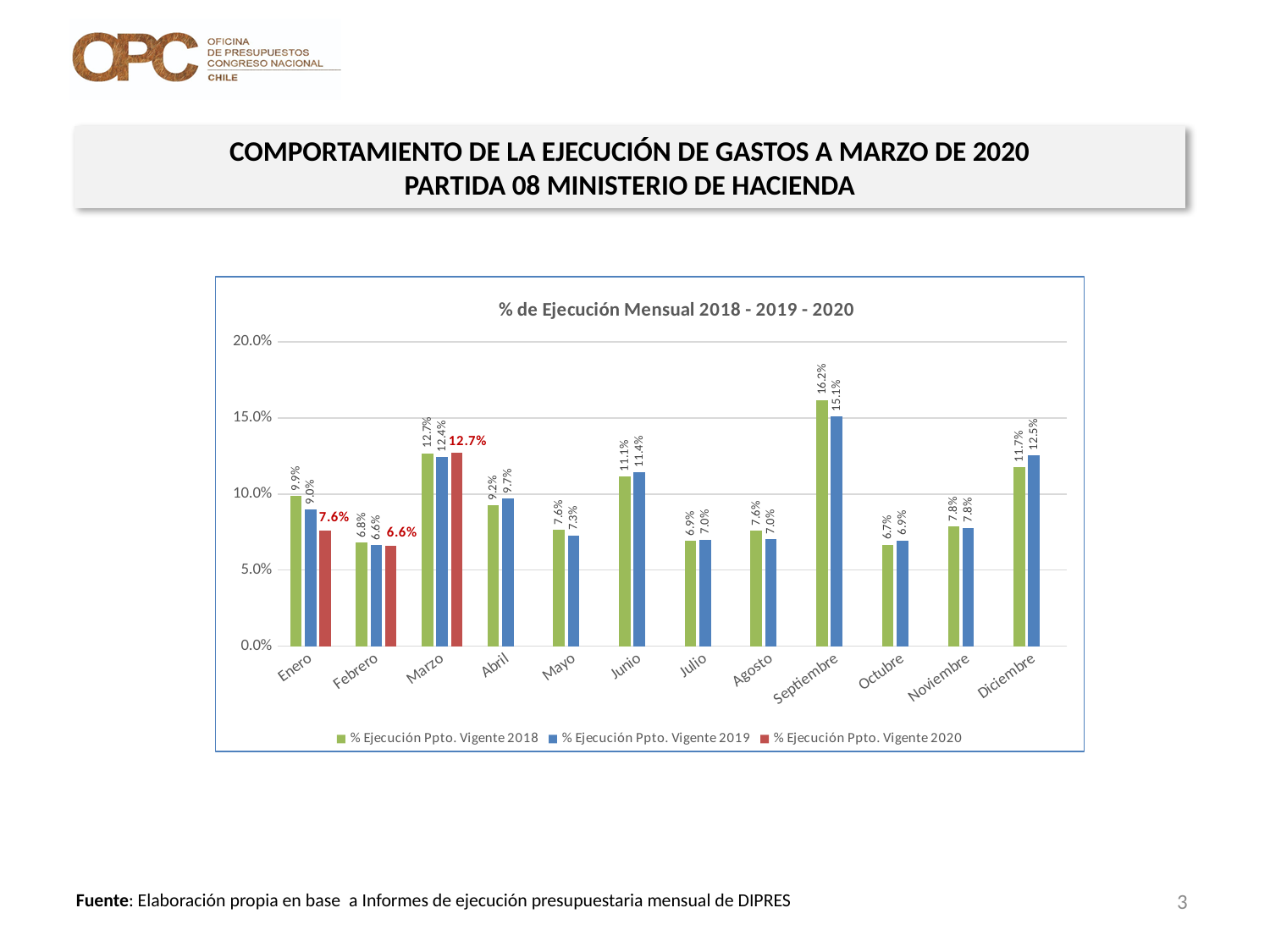
What is the value for % Ejecución Ppto. Vigente 2019 in Diciembre? 12.5% How many series does the legend list? 3 What is the difference between the 2018 and 2019 values in Septiembre? 1.1% What is the value for % Ejecución Ppto. Vigente 2020 in Marzo? 12.7% Which month has the highest value for % Ejecución Ppto. Vigente 2019? Septiembre Which is larger in Enero: the 2018 value or the 2020 value? 2018 value What kind of chart is shown? Bar chart What is the value for % Ejecución Ppto. Vigente 2018 in Septiembre? 16.2% How many months are shown on the x axis? 12 What is the value for % Ejecución Ppto. Vigente 2020 in Enero? 7.6% What is the title of the chart? % de Ejecución Mensual 2018 - 2019 - 2020 Which month has the lowest value for % Ejecución Ppto. Vigente 2018? Octubre